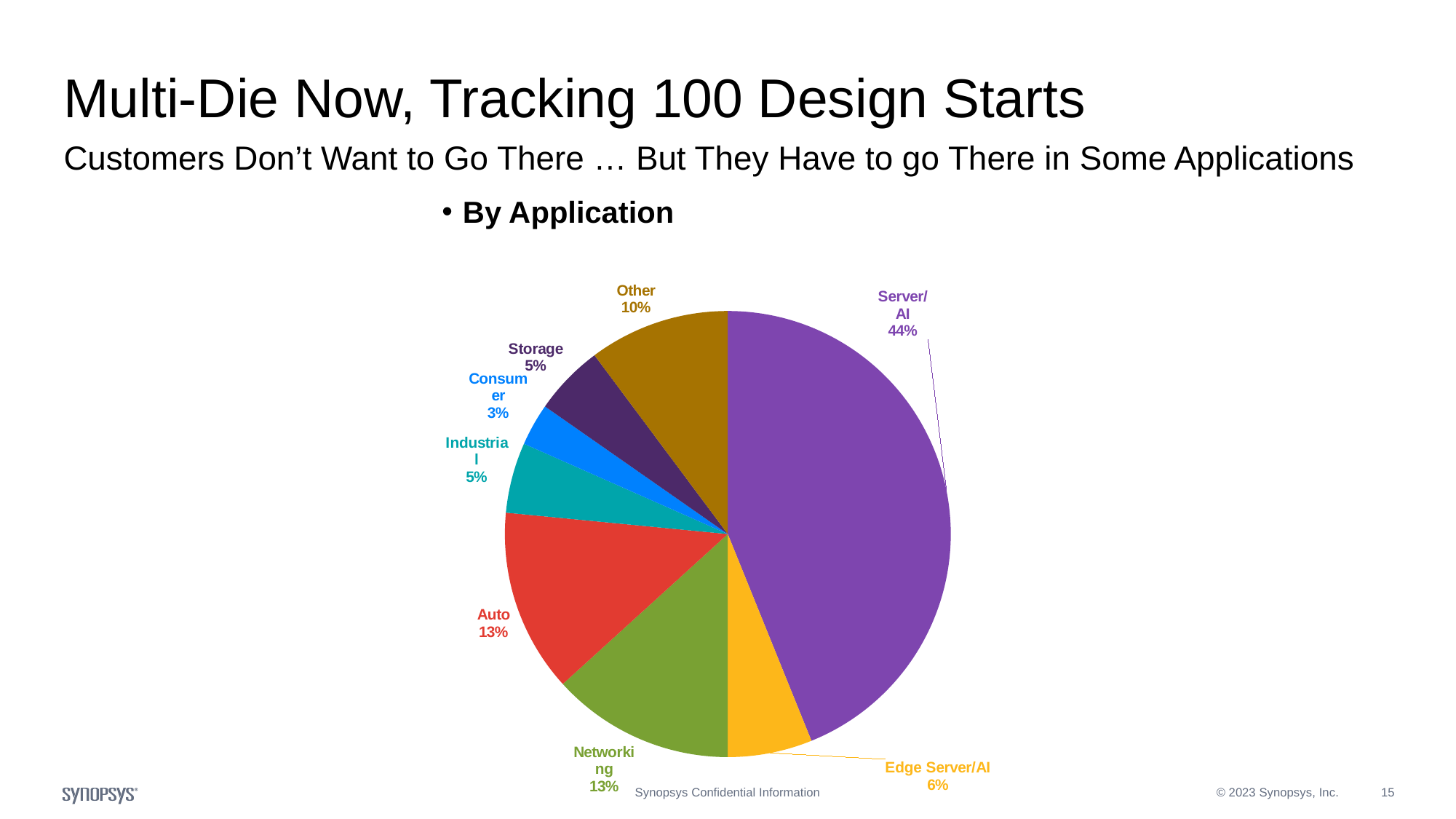
What share of the pie does Server/AI account for? 44% How many application categories are shown in the pie chart? 8 What is the combined share of Storage and Industrial? 10% What percentage is shown for Auto? 13% Which application has the largest share of the pie? Server/AI Which is larger, the share for Other or the share for Edge Server/AI? Other What colour is the Server/AI slice? Purple Which application has the smallest share of the pie? Consumer What is the difference in percentage points between Server/AI and Networking? 31 What percentage is shown for Consumer? 3% What percentage is shown for Edge Server/AI? 6% What kind of chart is shown on the slide? Pie chart